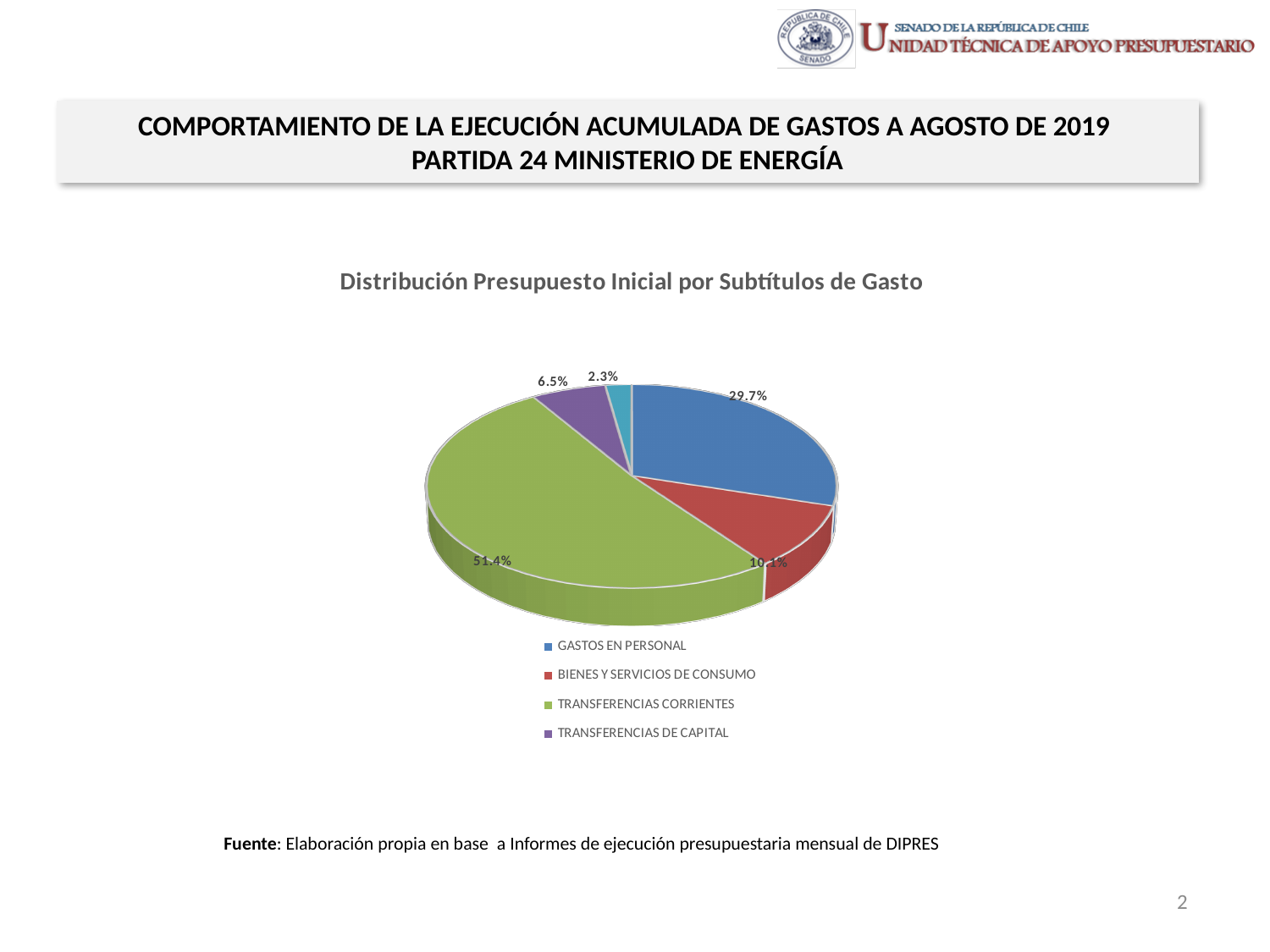
What share of the pie does BIENES Y SERVICIOS DE CONSUMO have? 10.1% What is the smallest percentage labelled on the pie? 2.3% What share of the pie does TRANSFERENCIAS DE CAPITAL have? 6.5% Which category has the largest share of the pie? TRANSFERENCIAS CORRIENTES What share of the pie does TRANSFERENCIAS CORRIENTES have? 51.4% What kind of chart is shown on the slide? pie chart What is the title of the chart? Distribución Presupuesto Inicial por Subtítulos de Gasto How many entries does the legend list? 4 What is the difference in percentage points between TRANSFERENCIAS CORRIENTES and GASTOS EN PERSONAL? 21.7 How many slices does the pie chart have? 5 Which is larger, the share for GASTOS EN PERSONAL or the share for BIENES Y SERVICIOS DE CONSUMO? GASTOS EN PERSONAL